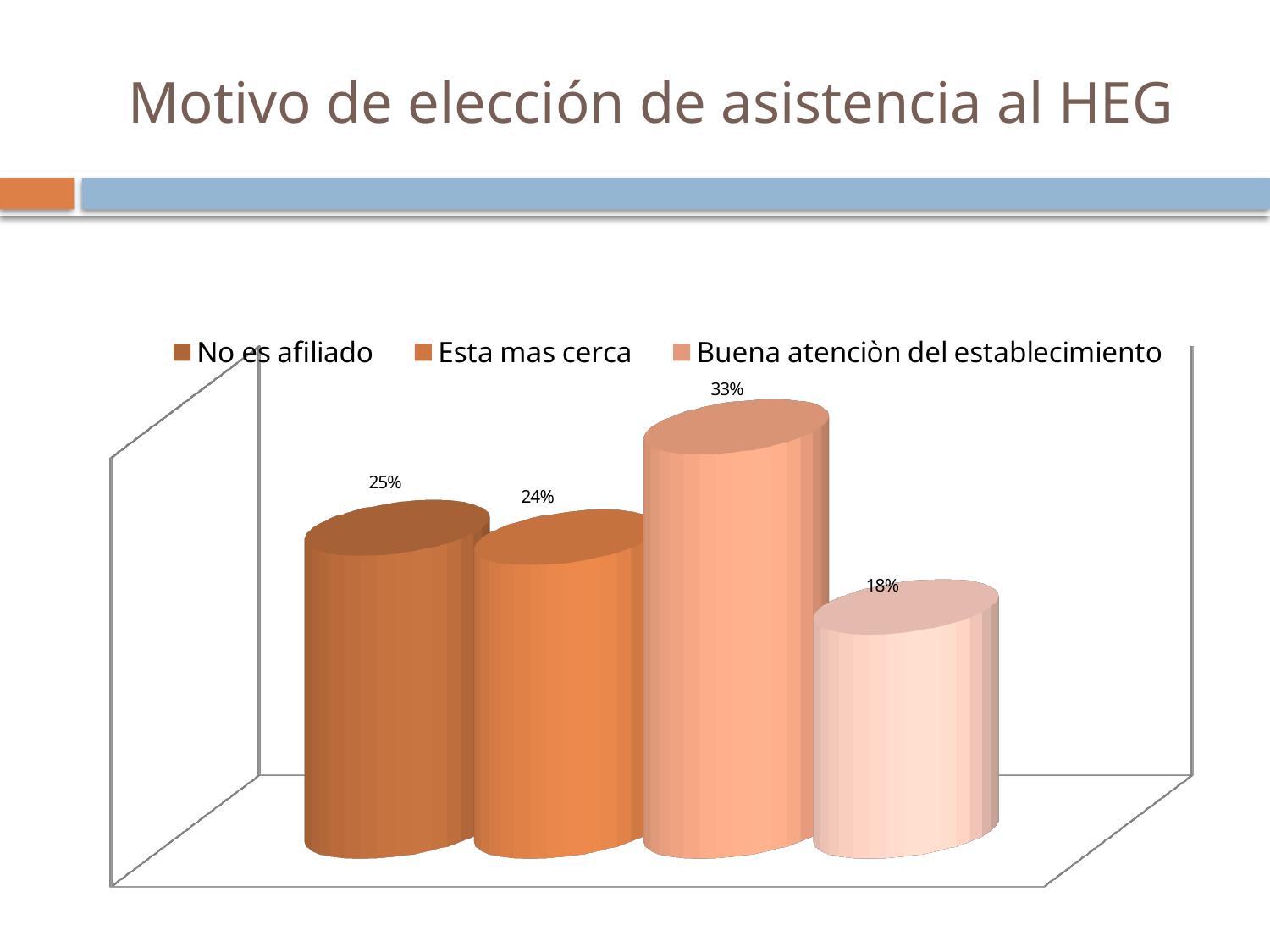
What is the value for "Buena atenciòn del establecimiento"? 33% What kind of chart is shown on the slide? Bar chart How many bars are plotted on the chart? 4 Which is larger, the value for "No es afiliado" or for "Esta mas cerca"? No es afiliado How many entries does the legend list? 3 What is the difference between the values for "No es afiliado" and "Esta mas cerca"? 1 percentage point What is the smallest value labelled on the chart? 18% Which legend category has the highest value? Buena atenciòn del establecimiento What is the difference between the values for "Buena atenciòn del establecimiento" and "No es afiliado"? 8 percentage points What is the value for "Esta mas cerca"? 24% What is the title of the slide? Motivo de elección de asistencia al HEG What is the value for "No es afiliado"? 25%